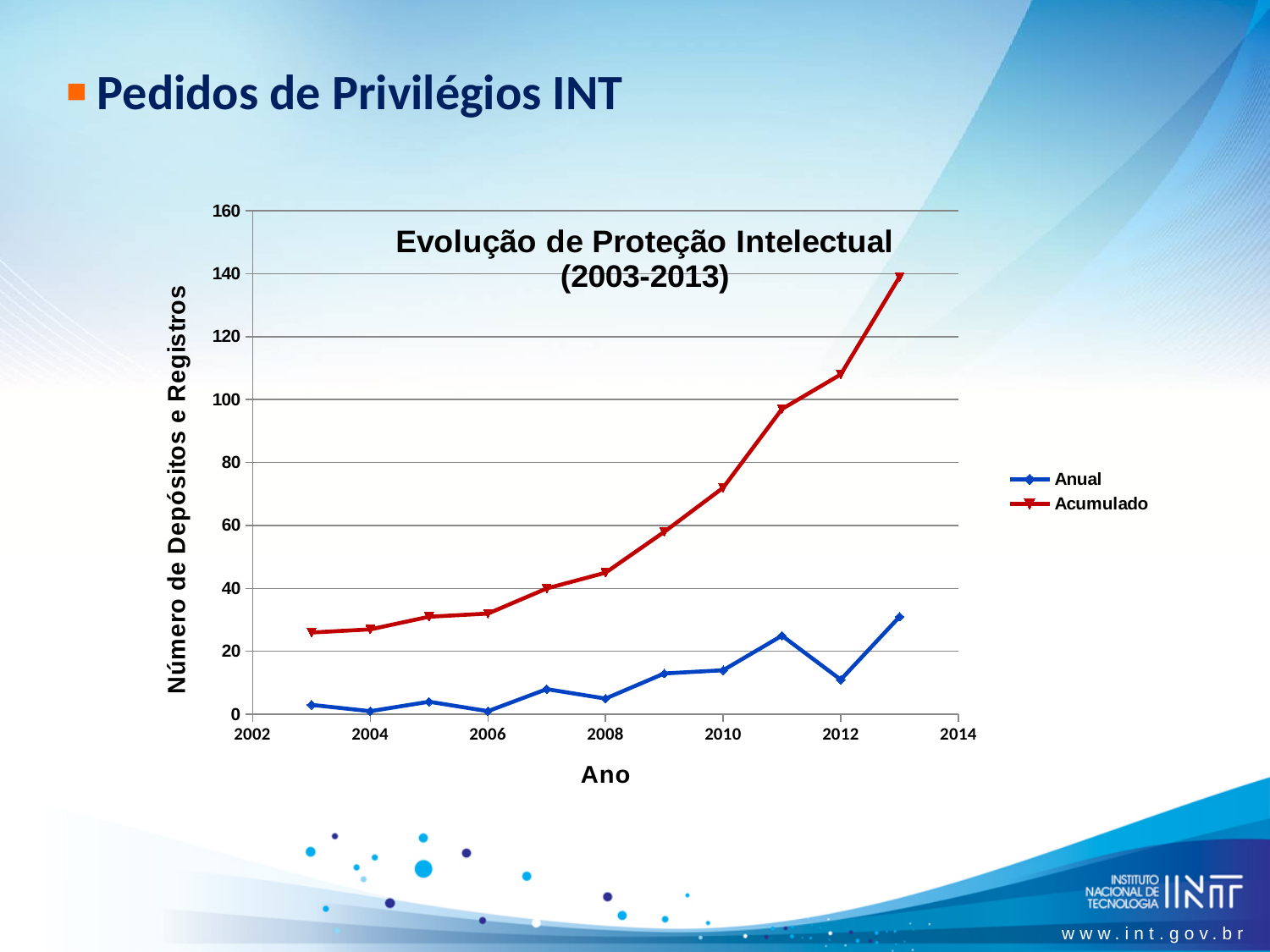
What kind of chart is shown on the slide? line chart Is the Anual value for 2012 greater or less than 20? less In 2010, which series has the larger value, Anual or Acumulado? Acumulado In which year does the Acumulado series reach its highest value? 2013 What are the two series named in the legend? Anual and Acumulado How many data points does the Acumulado series have? 11 Is the Acumulado value for 2012 greater or less than 100? greater In which year is the Acumulado series at its lowest value? 2003 Does the Acumulado series rise or fall from 2003 to 2013? rise How many series does the legend list? 2 In which year does the Anual series reach its highest value? 2013 What is the title printed inside the chart area? Evolução de Proteção Intelectual (2003-2013)